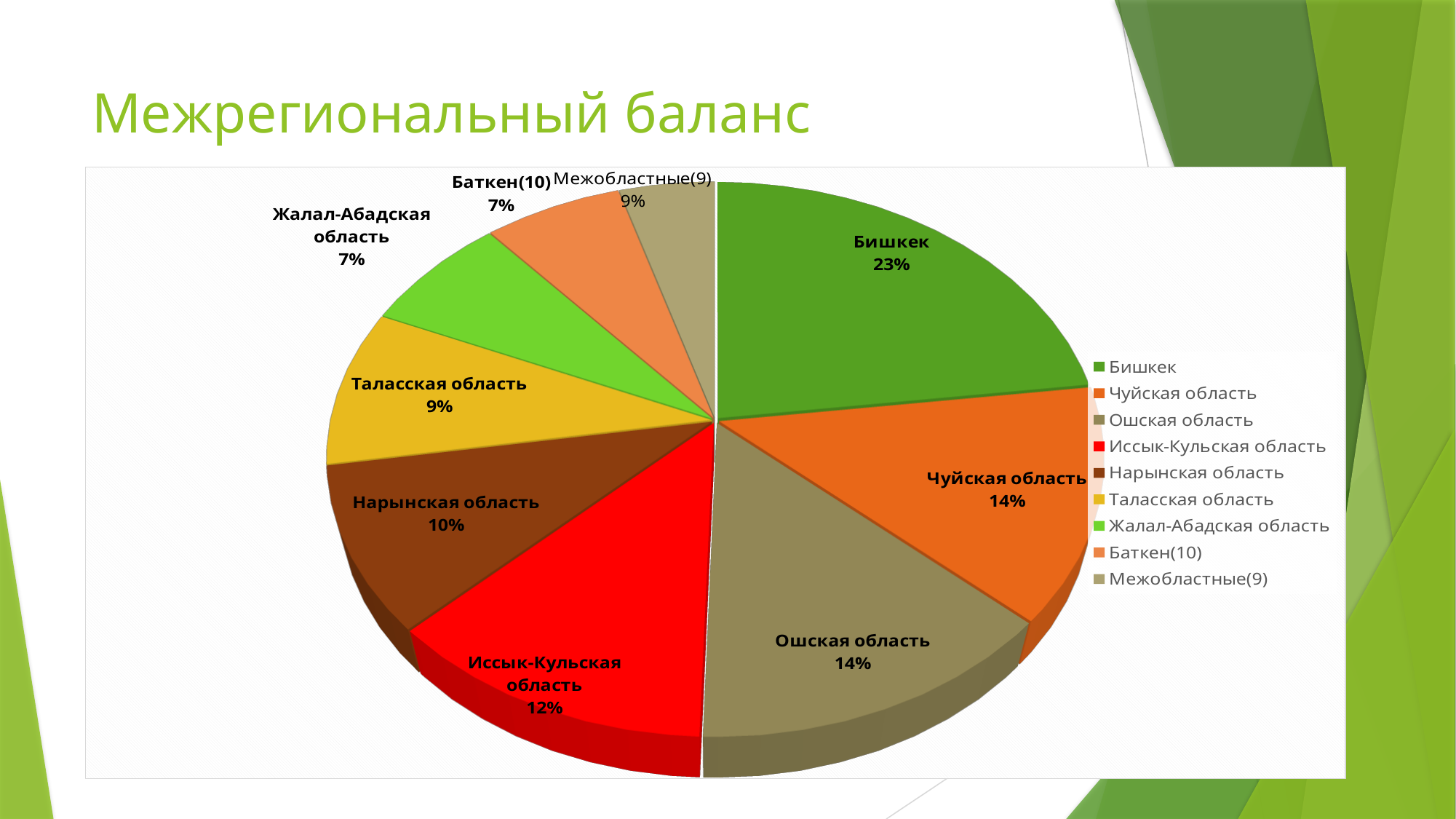
What colour is the slice for Иссык-Кульская область? Red What is the value shown for Нарынская область? 10% What kind of chart is shown on the slide? Pie chart What is the value shown for Межобластные(9)? 9% Which is larger, the value for Таласская область or the value for Иссык-Кульская область? Иссык-Кульская область How many slices does the pie chart have? 9 How many entries does the legend list? 9 What is the difference between the values for Бишкек and Чуйская область? 9% Which category has the largest slice of the pie? Бишкек What is the title of the slide containing the chart? Межрегиональный баланс What is the value shown for Иссык-Кульская область? 12% What share of the pie does Бишкек have? 23%